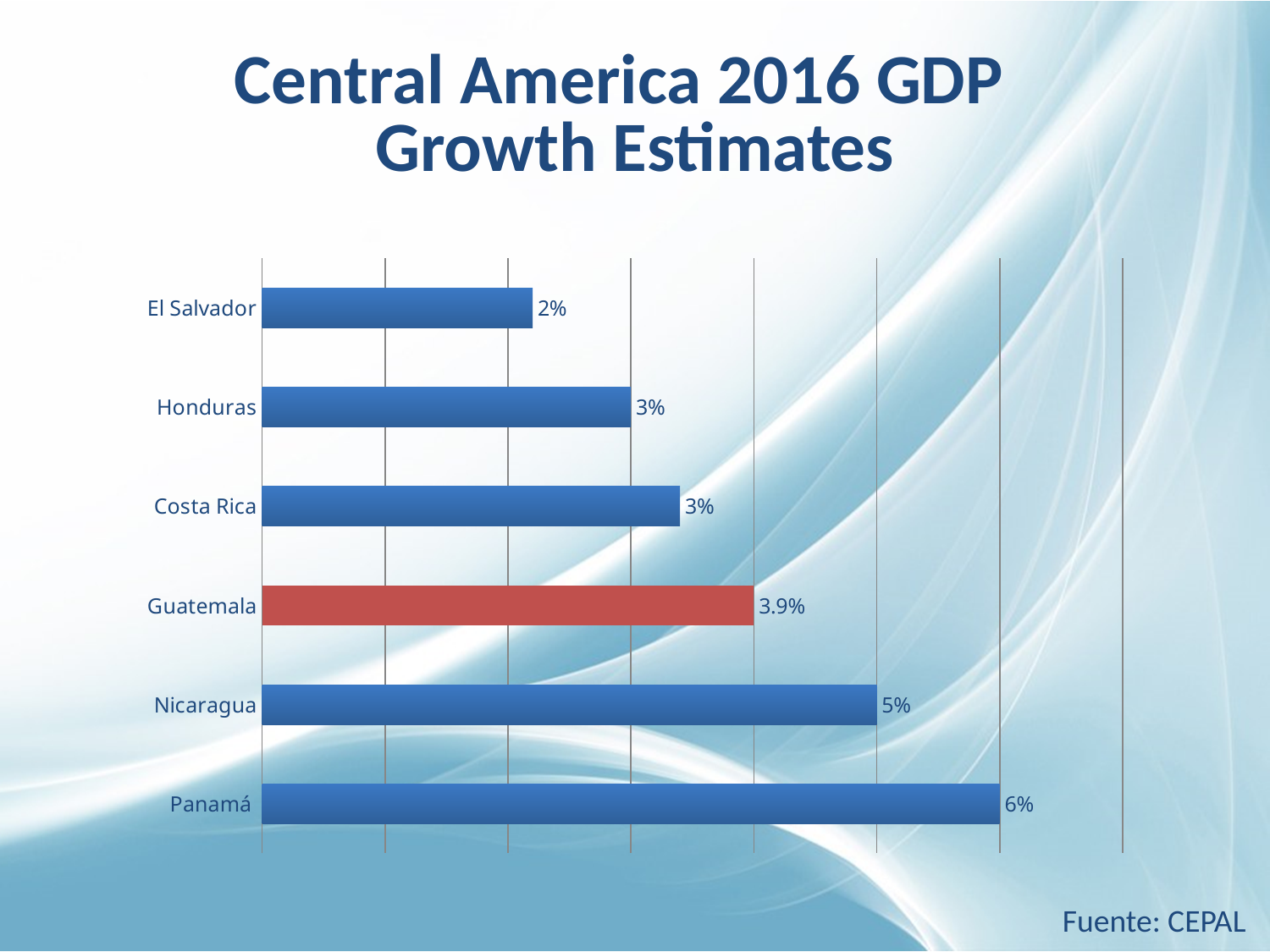
Which has a higher GDP growth estimate, Guatemala or Honduras? Guatemala What is the value shown for El Salvador? 2% Which country's bar is coloured red instead of blue? Guatemala What is the difference between the values for Nicaragua and Guatemala? 1.1% What is the value shown for Panamá? 6% How many countries are shown on the chart? 6 Which country has the highest GDP growth estimate on the chart? Panamá What kind of chart is shown on the slide? Bar chart Which country has the lowest GDP growth estimate on the chart? El Salvador What is the value shown for Nicaragua? 5% What is the 2016 GDP growth estimate shown for Guatemala? 3.9% What is the difference between the values for Panamá and El Salvador? 4%